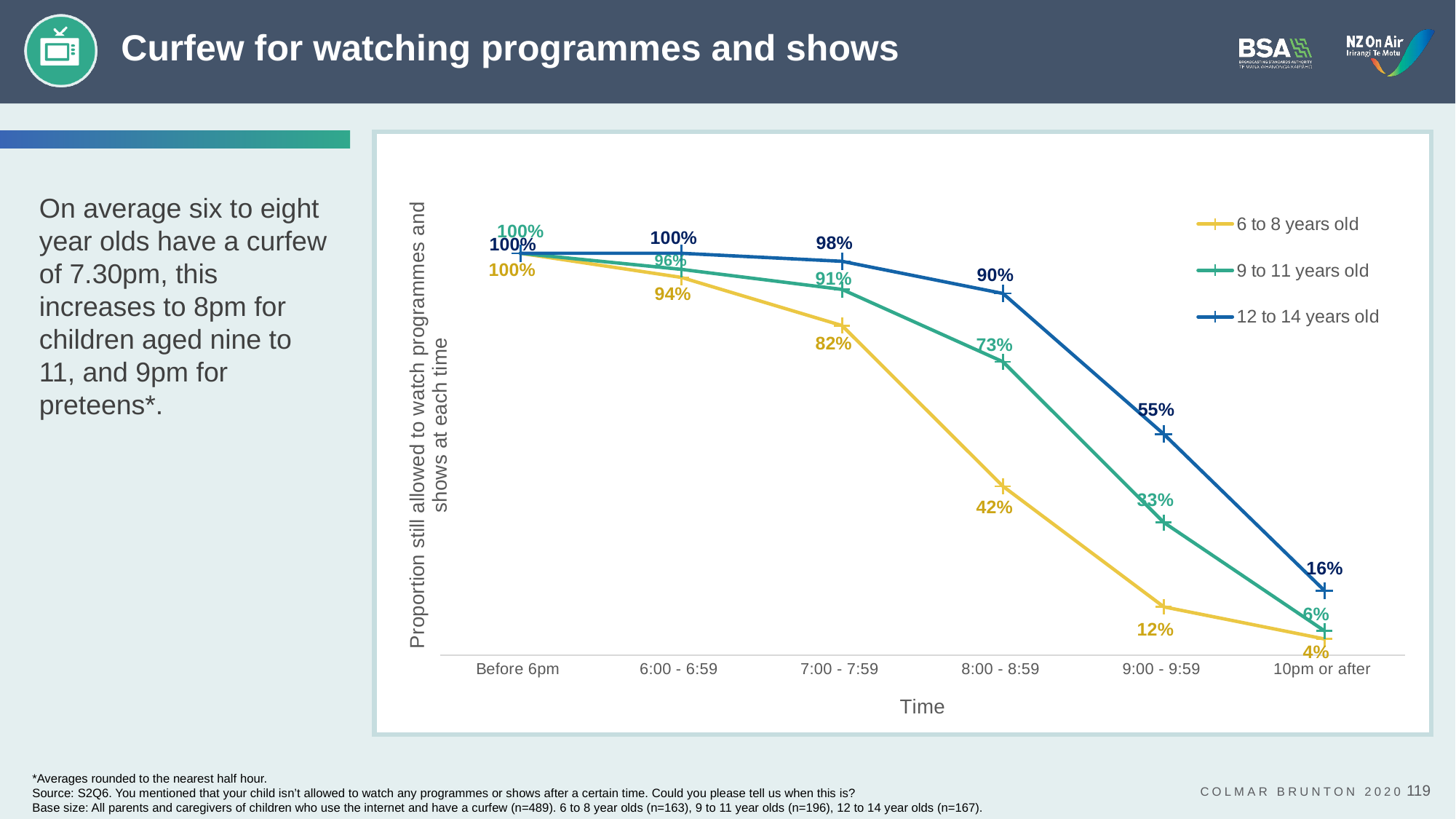
Do the values for 6 to 8 years old rise or fall across the time categories from left to right? Fall What is the value for 6 to 8 years old at 7:00 - 7:59? 82% What is the value for 12 to 14 years old at 9:00 - 9:59? 55% Which age group has the lowest value at 9:00 - 9:59? 6 to 8 years old Which age group has the highest value at 8:00 - 8:59? 12 to 14 years old What type of chart is shown on the slide? Line chart Which is larger at 10pm or after: the value for 9 to 11 years old or 12 to 14 years old? 12 to 14 years old How many series does the legend list? 3 What is the value for 9 to 11 years old at 8:00 - 8:59? 73% What is the value for 6 to 8 years old at 10pm or after? 4% What is the difference between the 12 to 14 years old and 6 to 8 years old values at 8:00 - 8:59? 48% How many time categories are shown on the x axis? 6